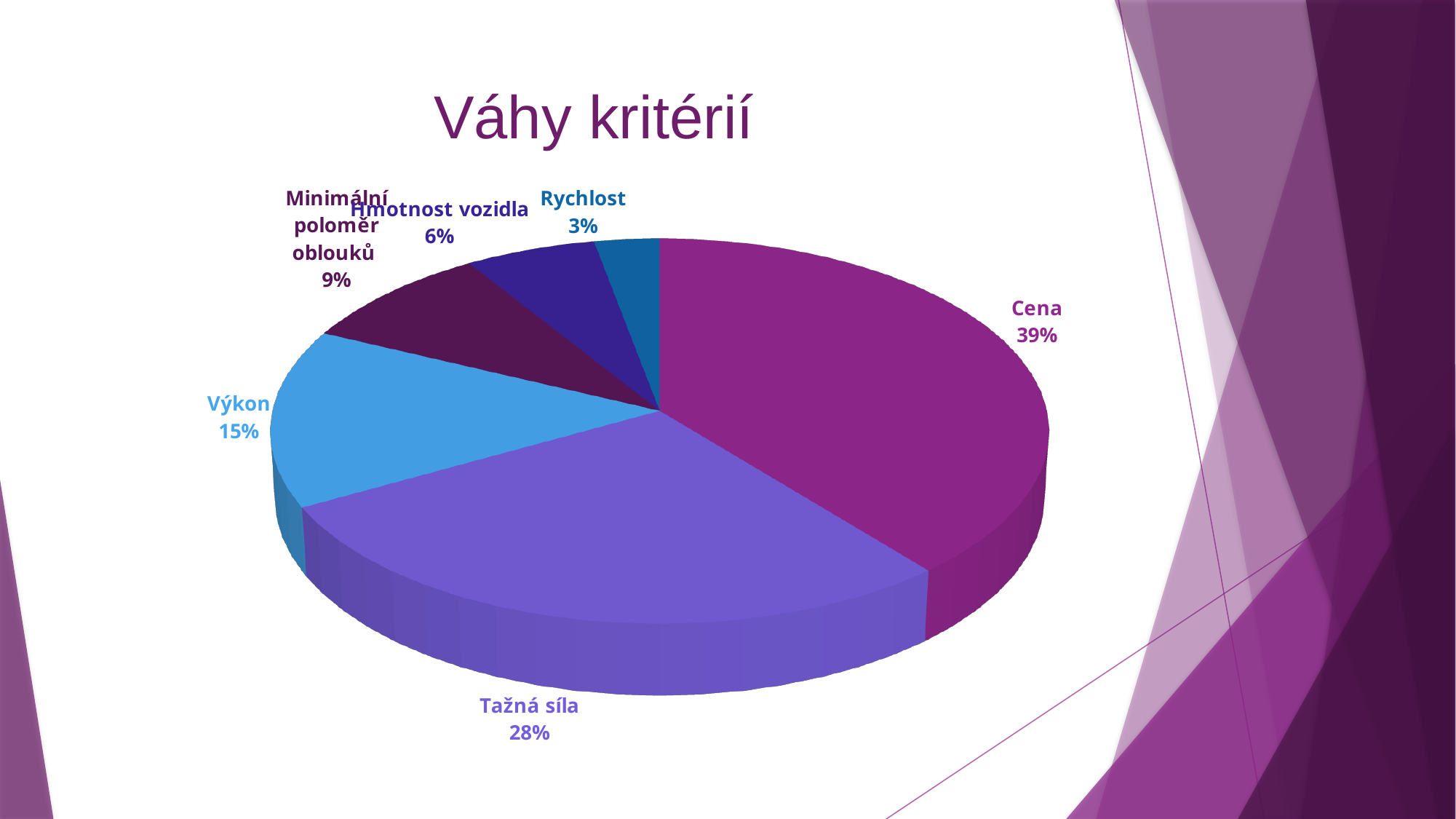
What share of the pie does Hmotnost vozidla have? 6% What share of the pie does Cena have? 39% How many categories are shown in the pie chart? 6 What share of the pie does Minimální poloměr oblouků have? 9% What share of the pie does Výkon have? 15% Which category has the smallest share of the pie? Rychlost Which category has the largest share of the pie? Cena What kind of chart is shown on the slide? pie chart What share of the pie does Tažná síla have? 28% What share of the pie does Rychlost have? 3% What is the title of the chart? Váhy kritérií What is the difference in percentage points between Cena and Tažná síla? 11